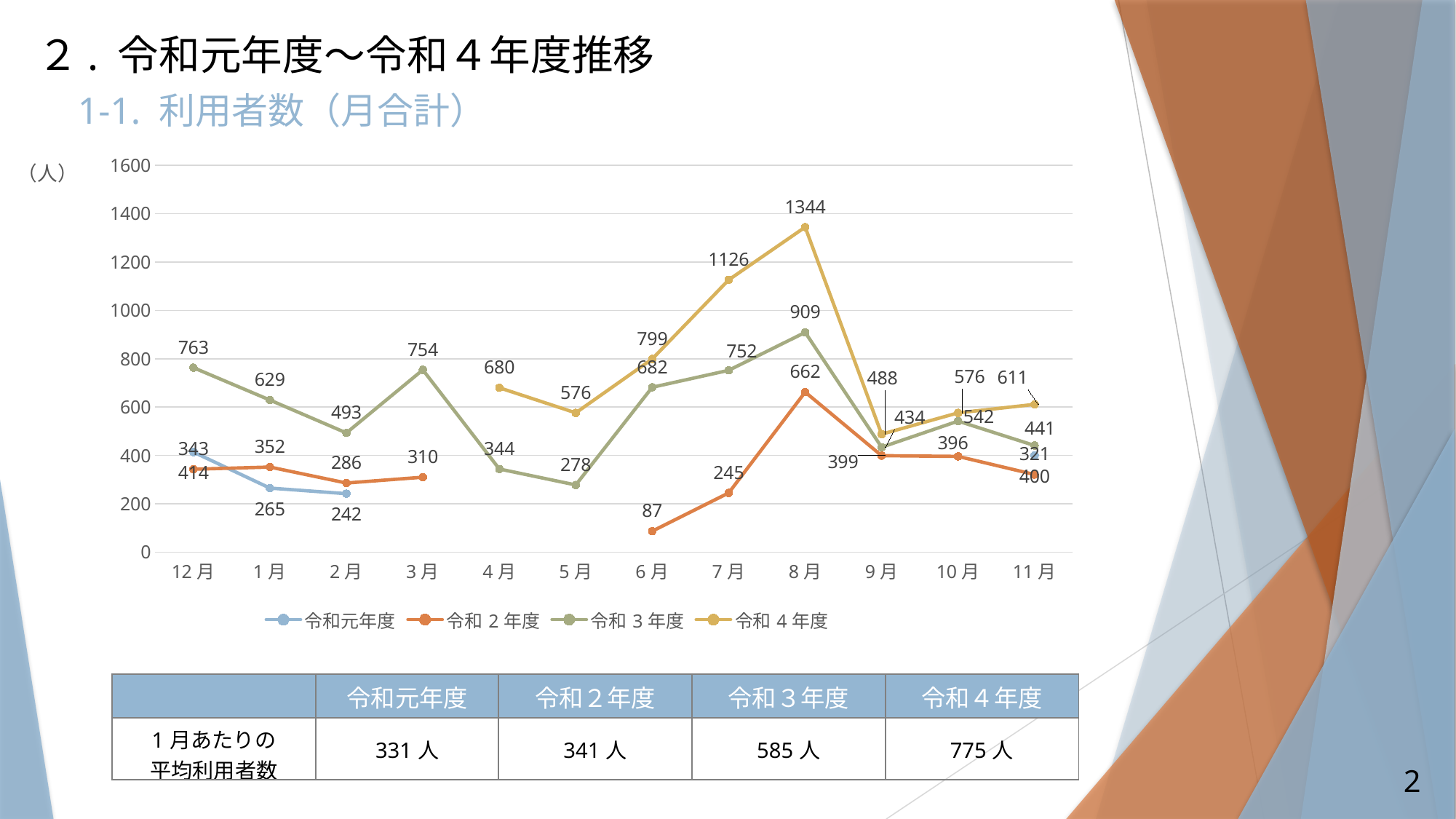
What unit is shown at the top of the y axis? （人） Which is larger in 8月: the value for 令和２年度 or for 令和３年度? 令和３年度 Does the 令和元年度 line rise or fall from 12月 to 2月? fall What is the value for 令和４年度 in 8月? 1344 How many months are shown on the x axis? 12 Which series and month has the lowest value on the chart? 令和２年度, 6月 How many series does the legend list? 4 What kind of chart is shown on the slide? line chart What is the value for 令和３年度 in 12月? 763 What is the difference between the 令和４年度 values for 8月 and 7月? 218 Which series and month has the highest value on the chart? 令和４年度, 8月 What is the value for 令和２年度 in 6月? 87